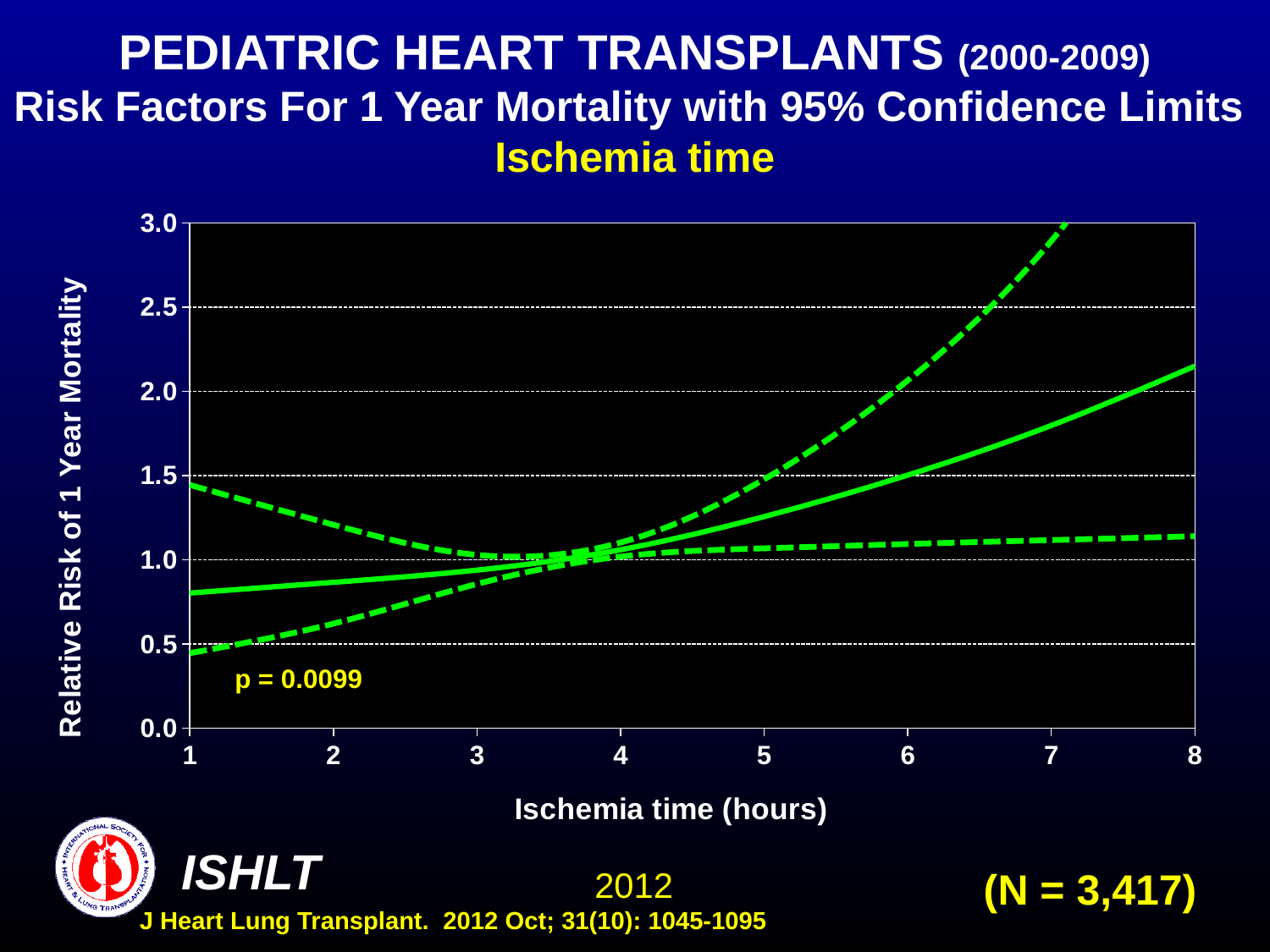
Does the solid line for relative risk of 1 year mortality rise or fall as ischemia time increases from 1 to 8 hours? rise Is the value of the solid relative risk line at 1 hour of ischemia time greater or less than 1.0? less Is the upper dashed confidence limit at 7 hours of ischemia time greater or less than 2.5? greater What is the label of the x axis of the chart? Ischemia time (hours) Is the value of the solid relative risk line at 8 hours of ischemia time greater or less than 2.0? greater What is the p-value shown on the chart? p = 0.0099 How many tick values are labelled on the x axis of the chart? 8 What kind of chart is shown on the slide? line chart How many lines are plotted on the chart? 3